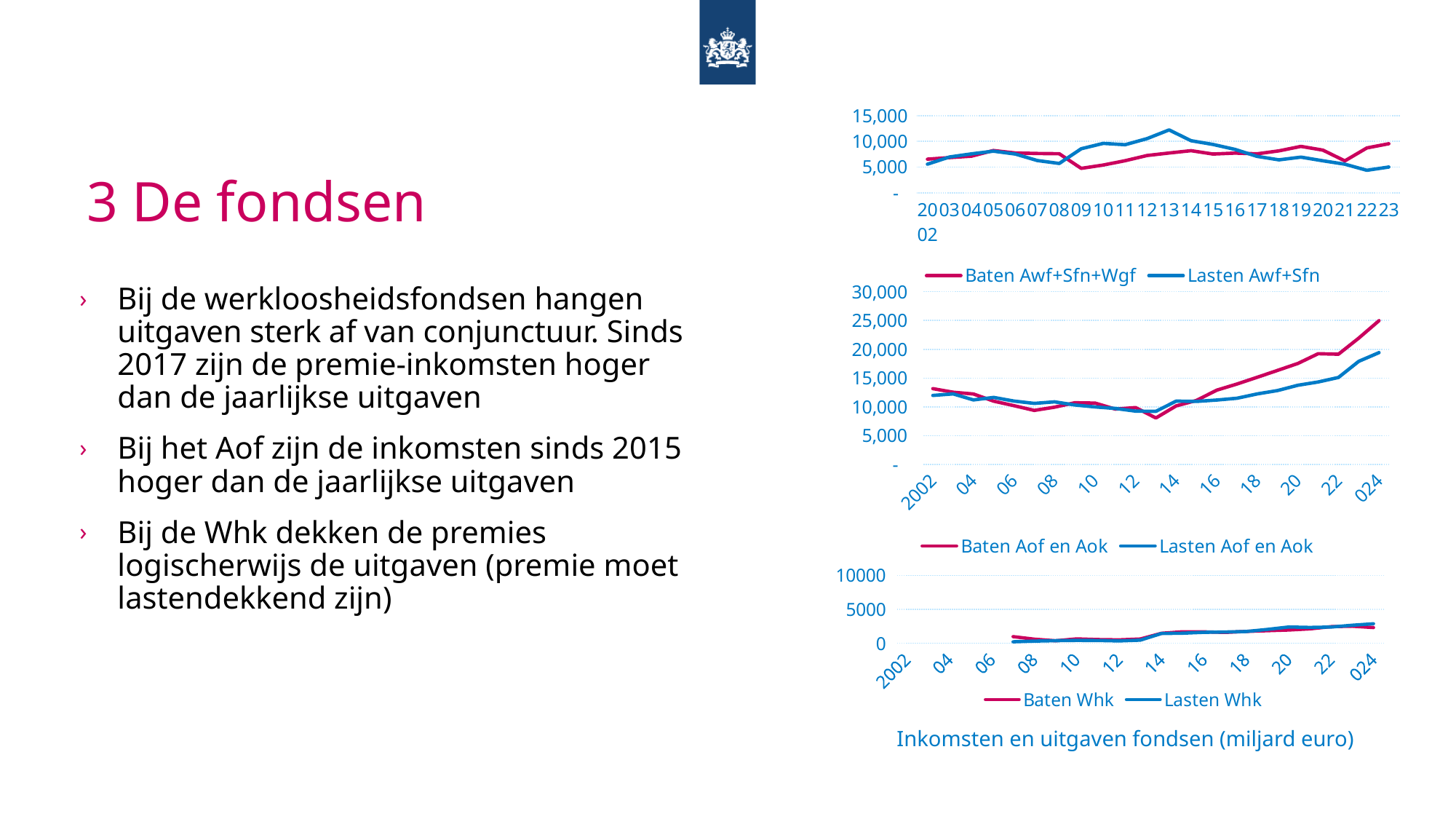
In the bottom chart (Whk), do the values of Lasten Whk generally rise or fall from 2008 to 2024? Rise In the middle chart (Aof en Aok), does Baten Aof en Aok rise or fall between 2014 and 2024? Rise In the middle chart (Aof en Aok), which series is higher in 2024, Baten Aof en Aok or Lasten Aof en Aok? Baten Aof en Aok In the bottom chart (Whk), is the value of Baten Whk in 2024 greater or less than 5000? less In the middle chart (Aof en Aok), is the value of Baten Aof en Aok in 2013 greater or less than 10,000? less What caption is shown below the three charts? Inkomsten en uitgaven fondsen (miljard euro) How many series does the legend of the middle chart (Aof en Aok) list? 2 What kind of chart is the top chart on the slide (Baten Awf+Sfn+Wgf / Lasten Awf+Sfn)? Line chart In the middle chart (Aof en Aok), is the value of Baten Aof en Aok in 2024 greater or less than 20,000? greater In the bottom chart (Whk), what are the two series named in the legend? Baten Whk and Lasten Whk